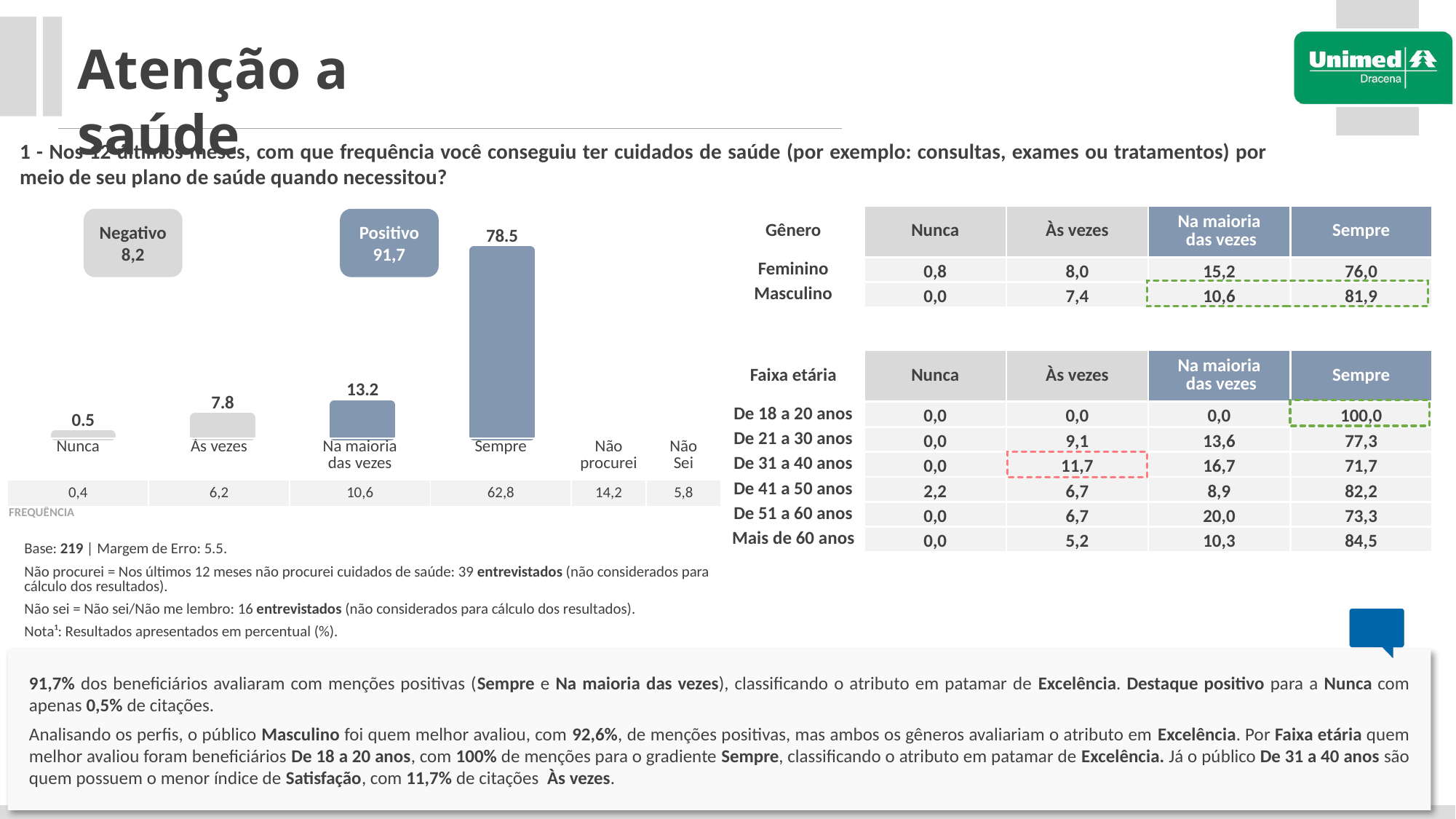
What is the difference between the values for Sempre and Na maioria das vezes? 65.3 Which category has the lowest bar in the chart? Nunca What is the value of the bar for Nunca? 0.5 Do the bar values rise or fall from Nunca to Sempre along the x axis? rise What kind of chart is shown on the left of the slide? bar chart What is the value of the bar for Às vezes? 7.8 What is the value of the bar for Sempre? 78.5 How many bars with data labels are plotted in the chart? 4 Which is larger, the bar for Às vezes or the bar for Na maioria das vezes? Na maioria das vezes What is the value of the bar for Na maioria das vezes? 13.2 Which category has the highest bar in the chart? Sempre What is the difference between the values for Às vezes and Nunca? 7.3